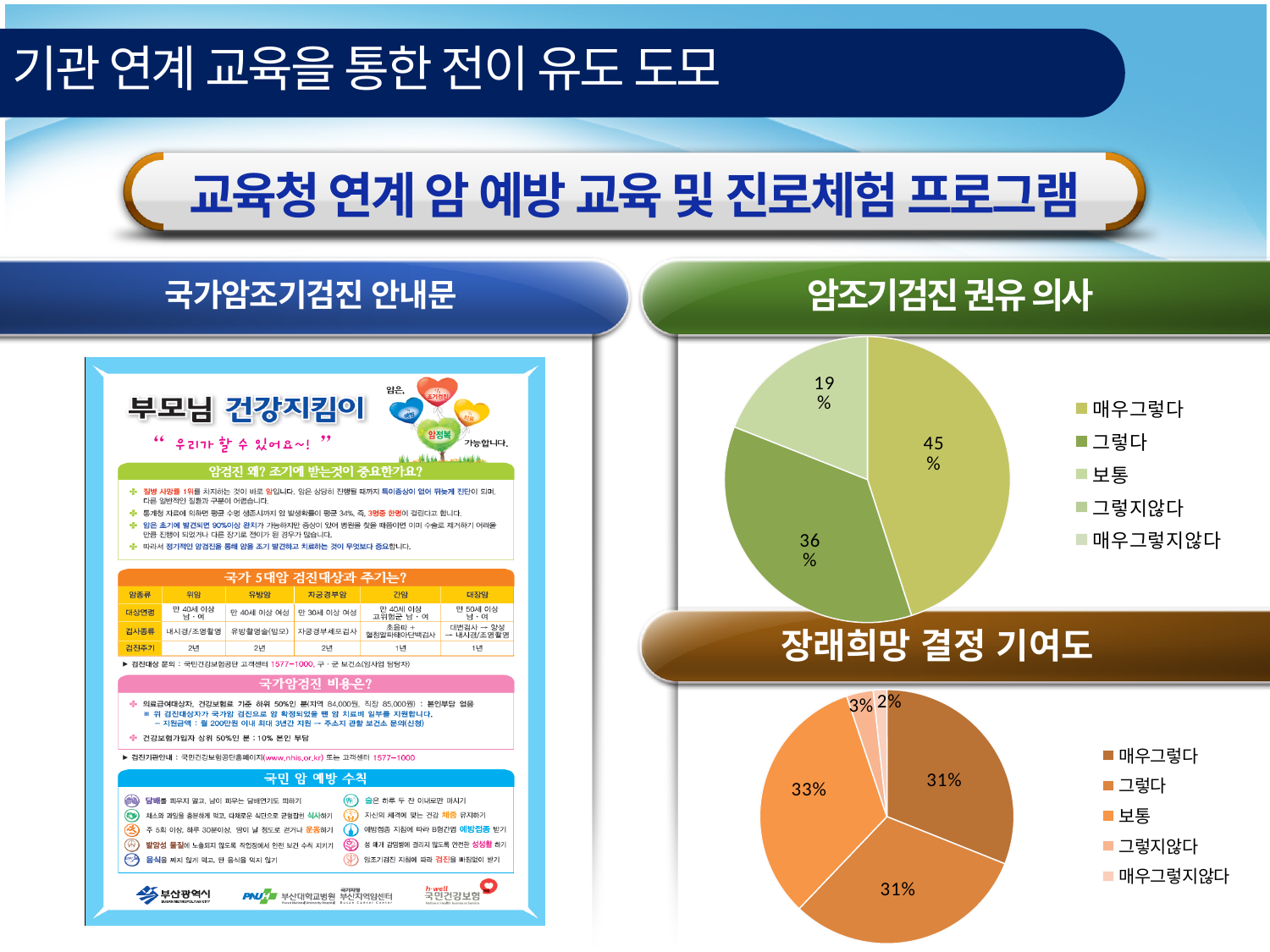
In the '장래희망 결정 기여도' chart, what percentage is shown for 보통? 33% In the '장래희망 결정 기여도' chart, what is the difference between the 보통 and 그렇지않다 slices? 30% In the '암조기검진 권유 의사' chart, which category has the largest slice? 매우그렇다 In the '암조기검진 권유 의사' chart, what percentage is shown for 그렇다? 36% In the '암조기검진 권유 의사' chart, what percentage is shown for 보통? 19% In the '장래희망 결정 기여도' chart, which category has the smallest slice? 매우그렇지않다 In the '암조기검진 권유 의사' chart, what percentage is shown for 매우그렇다? 45% How many entries does the legend of the '암조기검진 권유 의사' chart list? 5 In the '장래희망 결정 기여도' chart, what percentage is shown for 그렇지않다? 3% In the '암조기검진 권유 의사' chart, what is the difference between the 매우그렇다 and 그렇다 slices? 9% In the '장래희망 결정 기여도' chart, which is larger, the 보통 slice or the 매우그렇다 slice? 보통 What kind of chart is the '암조기검진 권유 의사' chart? Pie chart